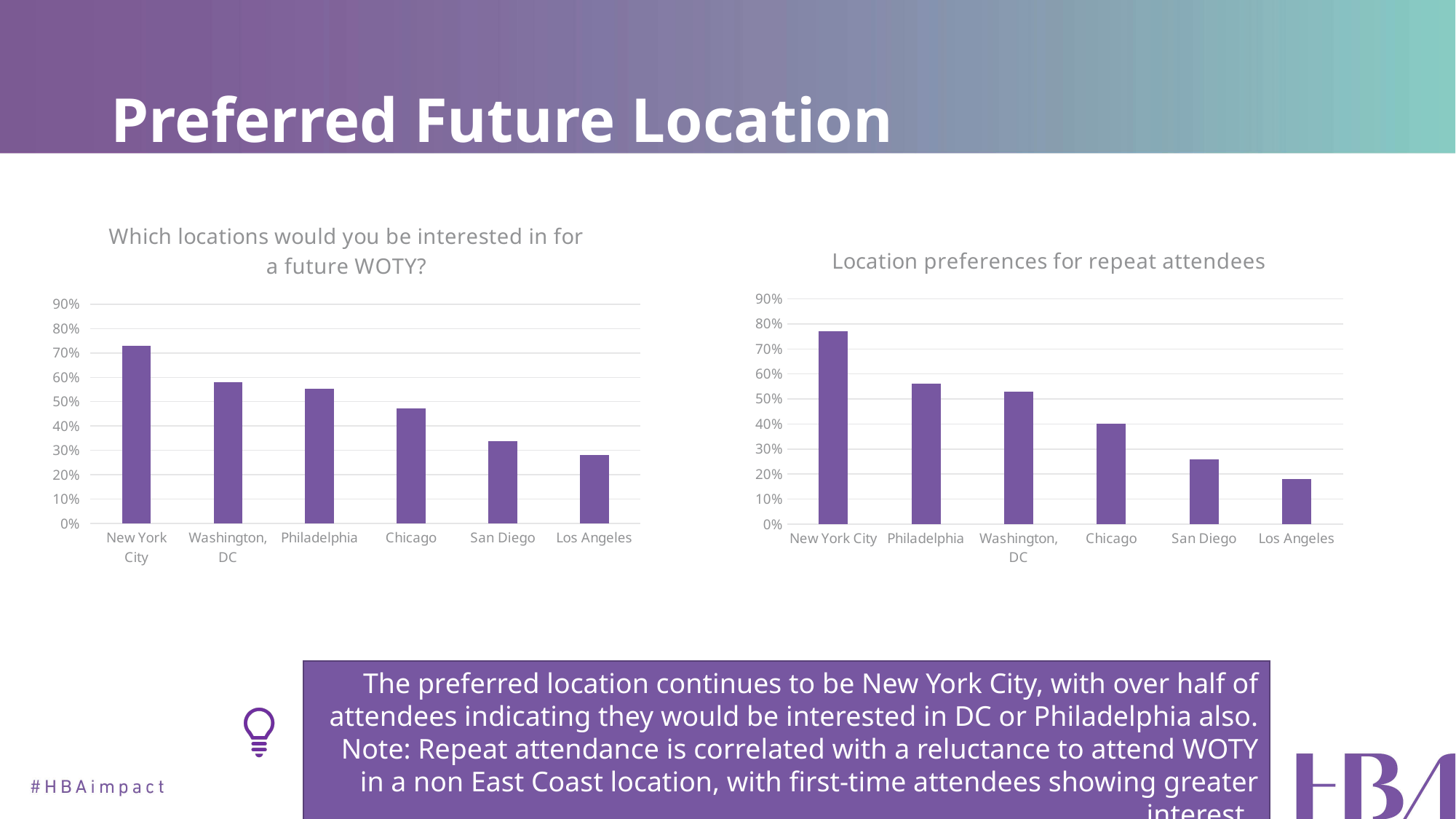
In the chart 'Location preferences for repeat attendees', is the value for Chicago greater or less than 50%? less In the chart 'Location preferences for repeat attendees', which location has the lowest bar? Los Angeles In the chart 'Which locations would you be interested in for a future WOTY?', is the value for New York City greater or less than 60%? greater In the chart 'Which locations would you be interested in for a future WOTY?', which location has the lowest bar? Los Angeles In the chart 'Location preferences for repeat attendees', do the values rise or fall moving from left to right along the x axis? fall What type of chart is the chart on the right of the slide? bar chart In the chart 'Location preferences for repeat attendees', is the value for New York City greater or less than 70%? greater In the chart 'Which locations would you be interested in for a future WOTY?', how many locations are shown on the x axis? 6 In the chart 'Location preferences for repeat attendees', which is larger, the value for Philadelphia or the value for San Diego? Philadelphia In the chart 'Which locations would you be interested in for a future WOTY?', which location has the highest bar? New York City In the chart 'Location preferences for repeat attendees', which location has the highest bar? New York City